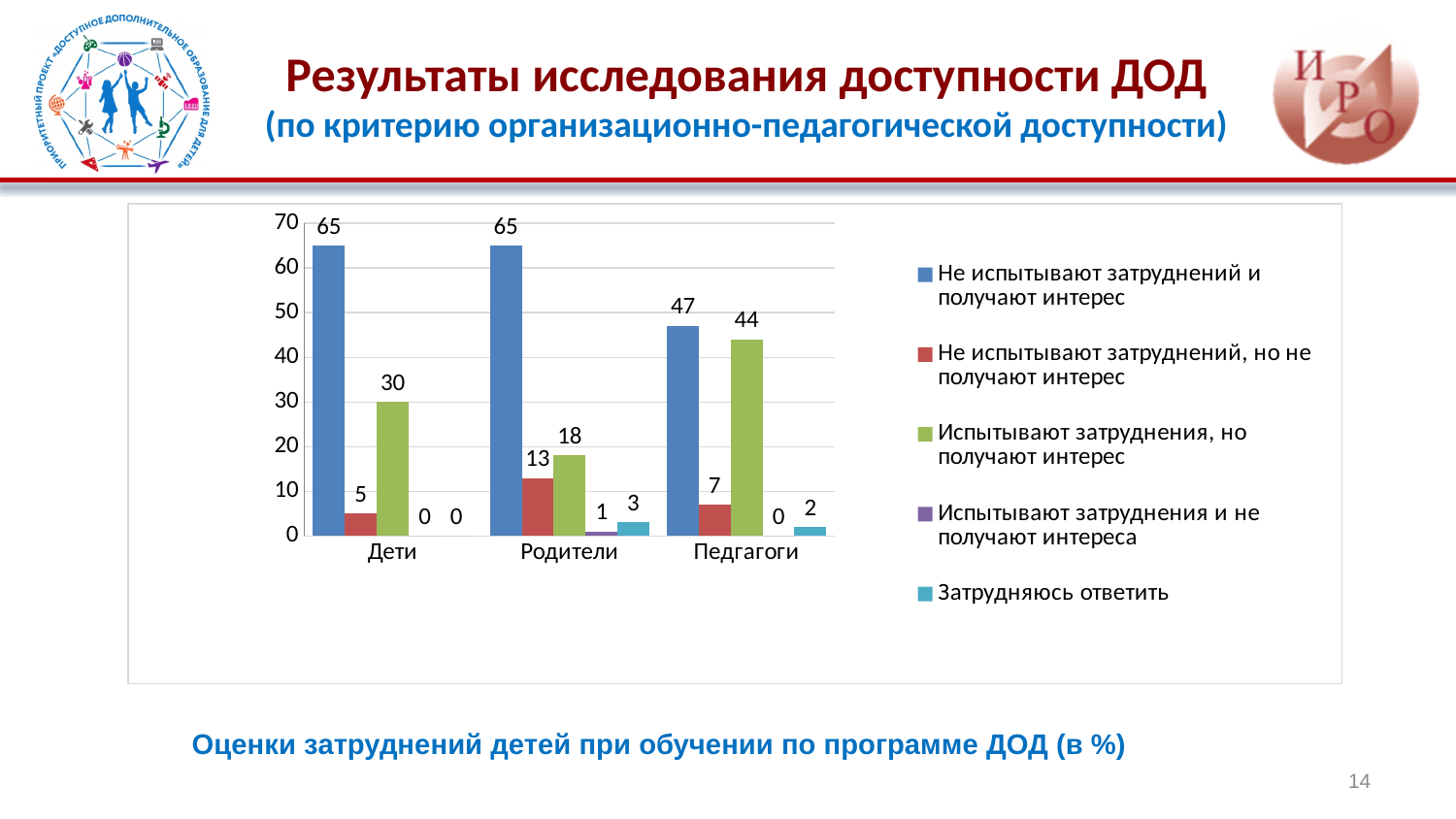
How many series does the legend list? 5 What is the value for Родители in the series "Затрудняюсь ответить"? 3 What is the value for Педагоги in the series "Испытывают затруднения, но получают интерес"? 44 What kind of chart is shown on the slide? Bar chart What colour are the bars for the series "Затрудняюсь ответить"? Light blue (cyan) What is the value for Дети in the series "Не испытывают затруднений и получают интерес"? 65 What is the value for Родители in the series "Не испытывают затруднений, но не получают интерес"? 13 Which category has the lowest value in the series "Не испытывают затруднений и получают интерес"? Педагоги What is the difference between the values for Дети and Педагоги in the series "Не испытывают затруднений и получают интерес"? 18 Which is larger: the value for Дети or for Родители in the series "Испытывают затруднения, но получают интерес"? Дети How many categories are shown on the x axis? 3 Which category has the highest value in the series "Испытывают затруднения, но получают интерес"? Педагоги